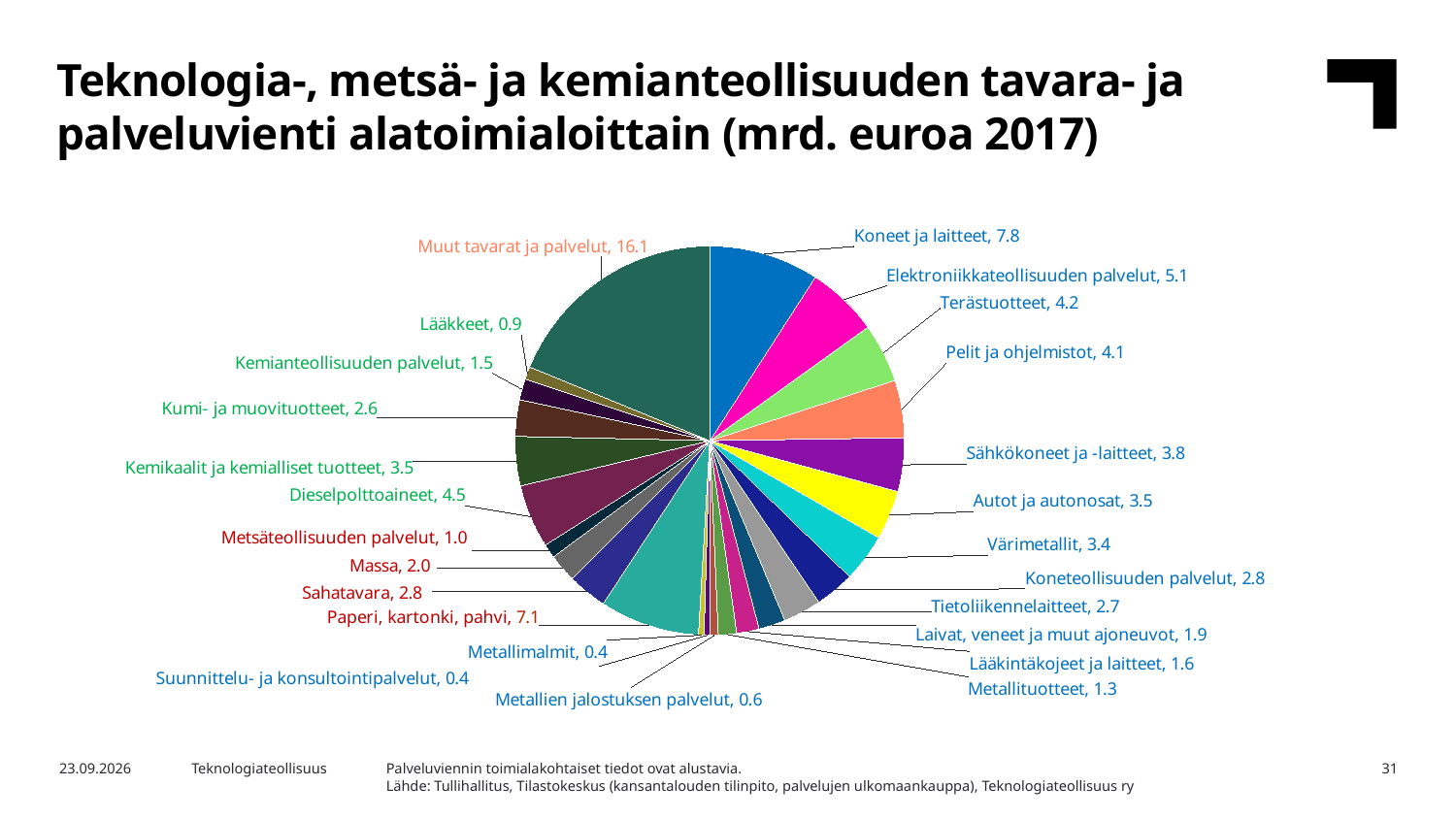
How many slices does the pie chart have? 25 What is the value for Paperi, kartonki, pahvi? 7.1 Which category has the largest slice in the pie chart? Muut tavarat ja palvelut What is the value for Lääkkeet? 0.9 What is the difference between Koneet ja laitteet and Paperi, kartonki, pahvi? 0.7 Which is larger, Terästuotteet or Pelit ja ohjelmistot? Terästuotteet What is the value for Tietoliikennelaitteet? 2.7 What type of chart is shown on the slide? pie chart What is the difference between Muut tavarat ja palvelut and Koneet ja laitteet? 8.3 What unit and year does the slide title give for the values? mrd. euroa 2017 What is the value for Koneet ja laitteet? 7.8 What is the value for Dieselpolttoaineet? 4.5